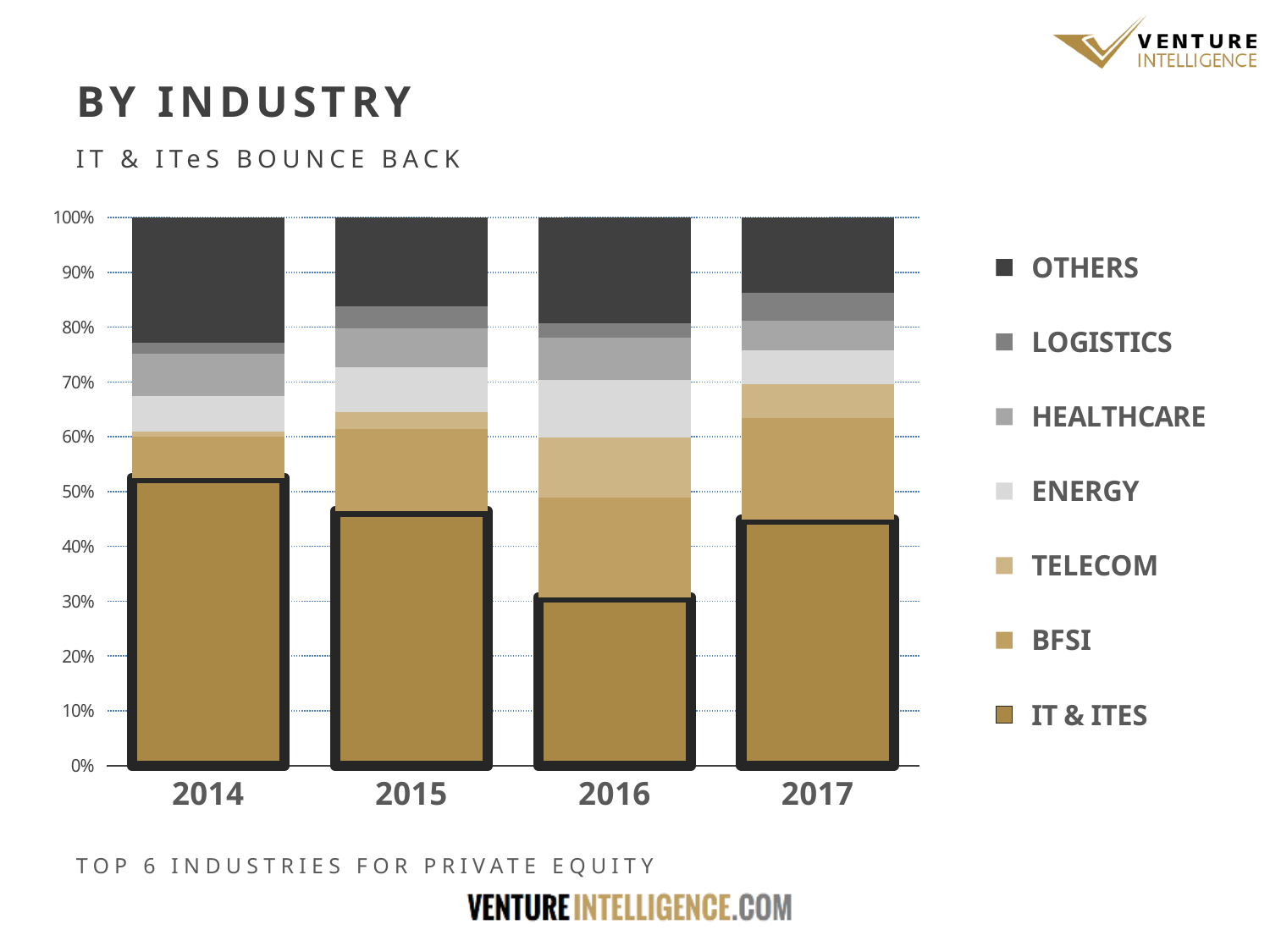
Is the IT & ITES share in 2016 greater or less than 40%? less What kind of chart is shown on the slide? Stacked bar chart Is the IT & ITES share in 2017 greater or less than 40%? greater Does the IT & ITES share rise or fall from 2014 to 2016? Fall Which year has the larger TELECOM share, 2014 or 2016? 2016 How many series does the chart's legend list? 7 In which year is the IT & ITES share the highest? 2014 Which year has the larger IT & ITES share, 2014 or 2016? 2014 Is the IT & ITES share in 2014 greater or less than 50%? greater What is the title of the slide containing the chart? BY INDUSTRY In which year is the IT & ITES share the lowest? 2016 How many years are shown on the x axis of the chart? 4